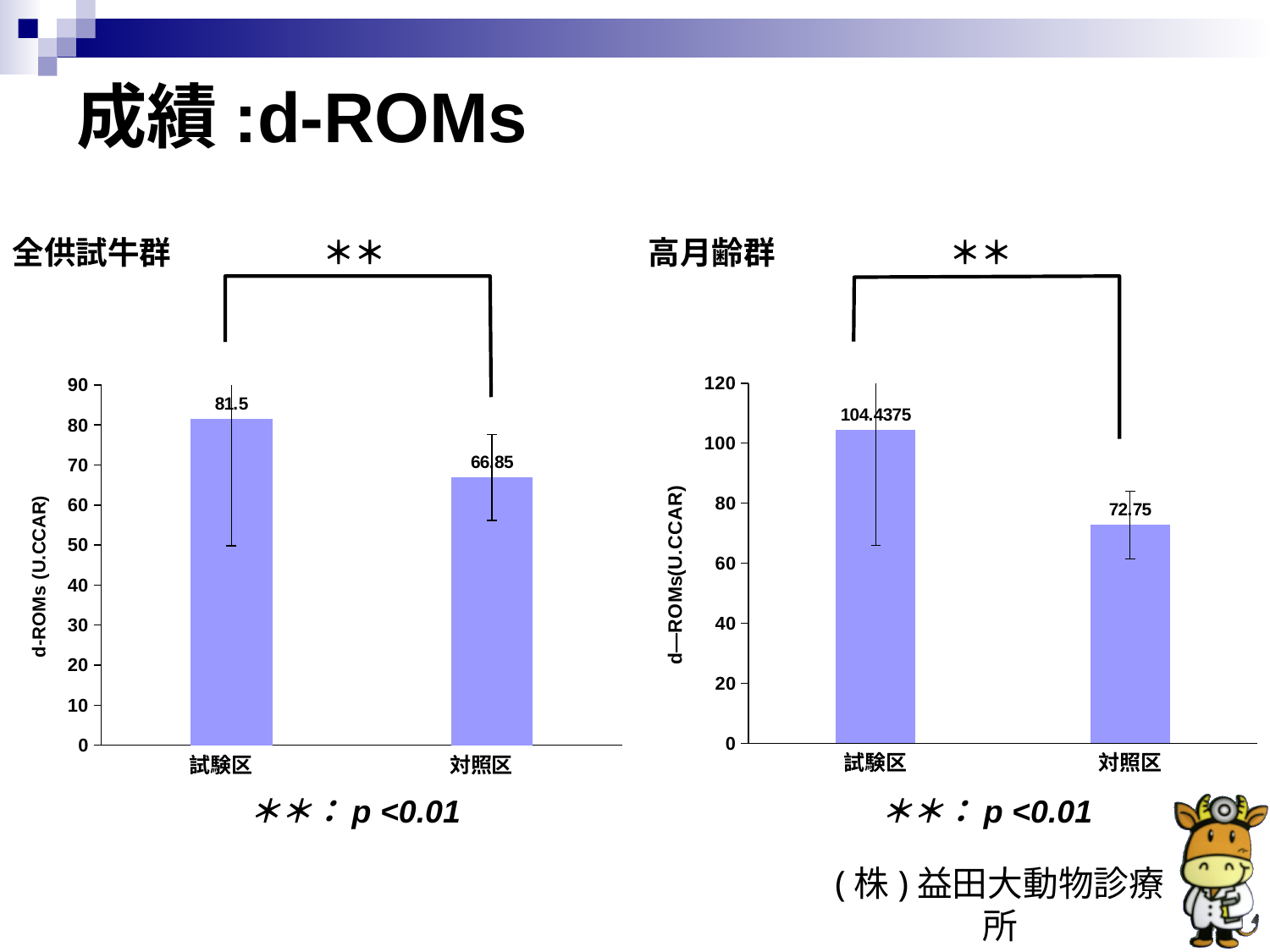
In the right chart (高月齢群), what is the d-ROMs value for 対照区? 72.75 What is the y-axis label of the left chart (全供試牛群)? d-ROMs (U.CCAR) In the left chart (全供試牛群), what is the d-ROMs value for 対照区? 66.85 In the right chart (高月齢群), what is the d-ROMs value for 試験区? 104.4375 In the left chart (全供試牛群), what is the difference between the 試験区 and 対照区 values? 14.65 In the right chart (高月齢群), which group has the lower d-ROMs value? 対照区 How many bars are plotted in the left chart (全供試牛群)? 2 In the left chart (全供試牛群), which group has the higher d-ROMs value? 試験区 In the left chart (全供試牛群), what is the d-ROMs value for 試験区? 81.5 In the right chart (高月齢群), what is the difference between the 試験区 and 対照区 values? 31.6875 What kind of chart is the right chart (高月齢群)? bar chart In the right chart (高月齢群), is the value for 試験区 greater or less than 100? greater